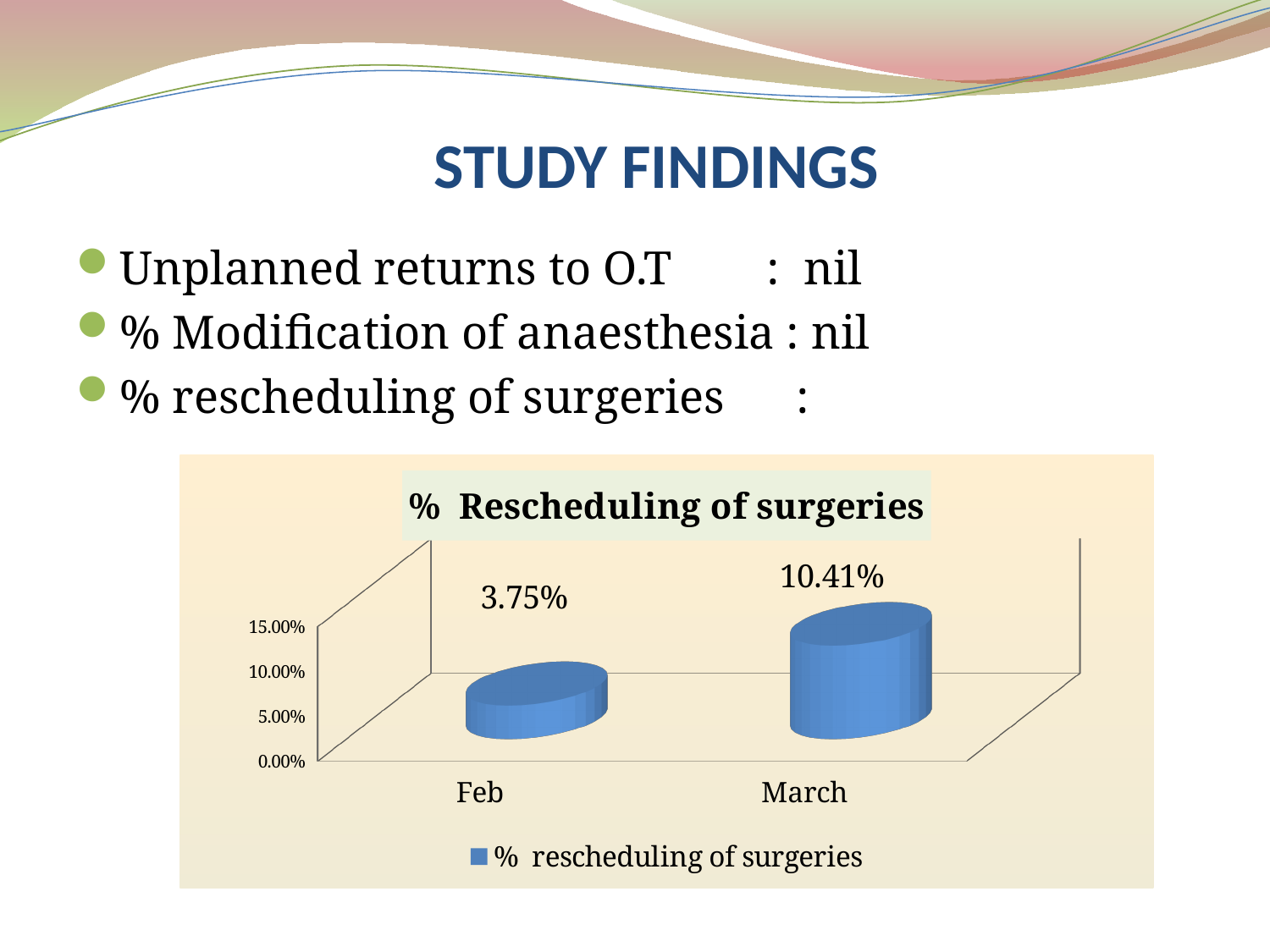
What is the value for Feb in the chart? 3.75% What is the value for March in the chart? 10.41% What kind of chart is shown on the slide? Bar chart Is the value for Feb greater or less than 5.00%? less What is the difference between the March and Feb values? 6.66% Which month has the lowest % rescheduling of surgeries? Feb How many categories are shown on the x axis of the chart? 2 Which is larger, the value for Feb or the value for March? March How many series does the legend list? 1 What is the title of the chart? % Rescheduling of surgeries Which month has the highest % rescheduling of surgeries? March Is the value for March greater or less than 5.00%? greater